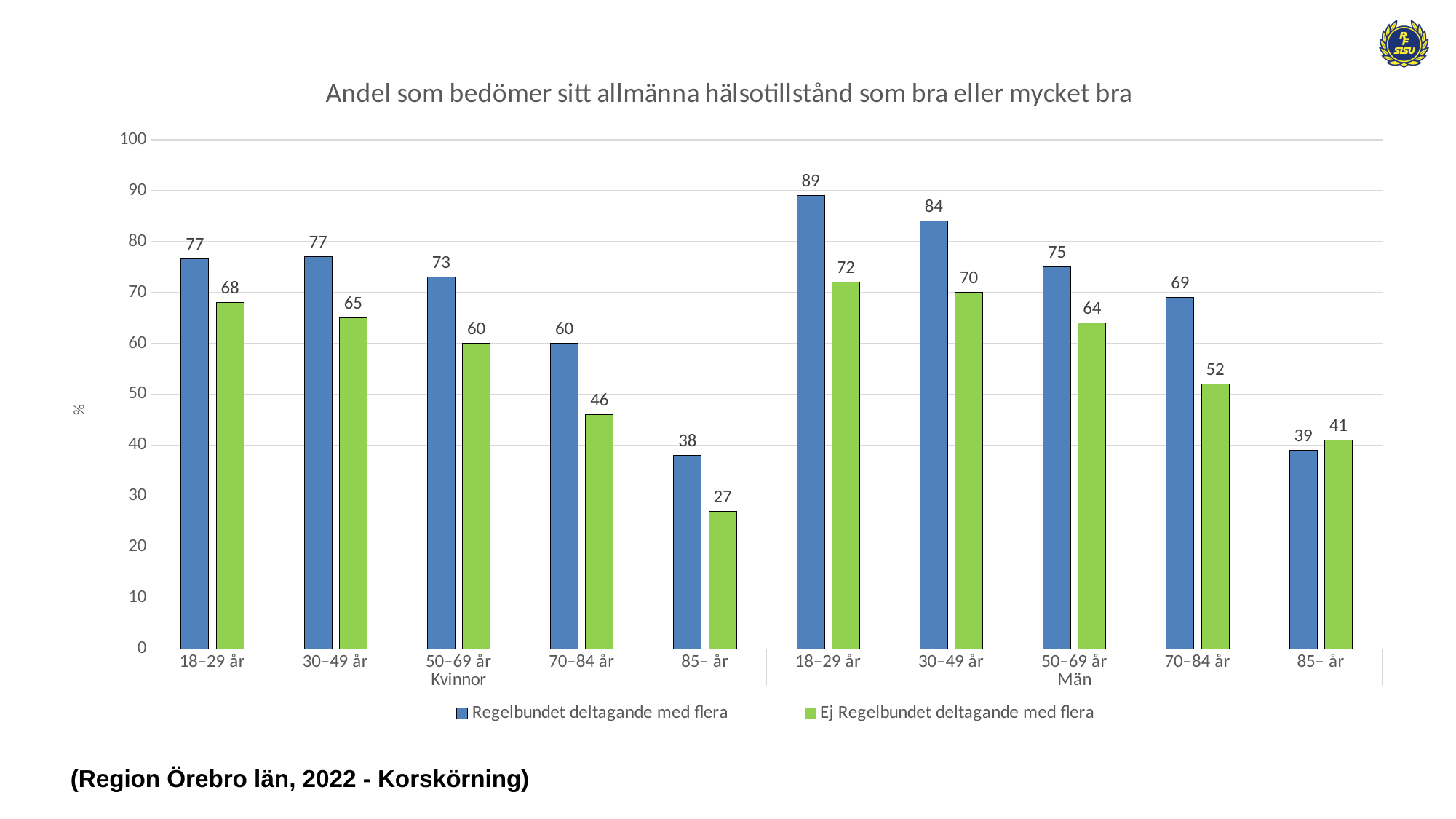
How many age-group categories are shown on the x axis in total? 10 What colour are the bars for 'Ej Regelbundet deltagande med flera'? Green How many series does the legend list? 2 What is the title of the chart? Andel som bedömer sitt allmänna hälsotillstånd som bra eller mycket bra What is the value for 'Ej Regelbundet deltagande med flera' for Män aged 70–84 år? 52 What is the difference between 'Regelbundet deltagande med flera' and 'Ej Regelbundet deltagande med flera' for Kvinnor aged 70–84 år? 14 Which group has the highest value for 'Regelbundet deltagande med flera'? Män 18–29 år Do the values for 'Regelbundet deltagande med flera' among Kvinnor rise or fall from 18–29 år to 85– år? Fall What is the value for 'Regelbundet deltagande med flera' for Kvinnor aged 18–29 år? 77 What kind of chart is shown on the slide? Bar chart For Män aged 85– år, which is larger: 'Regelbundet deltagande med flera' or 'Ej Regelbundet deltagande med flera'? Ej Regelbundet deltagande med flera Which group has the lowest value for 'Ej Regelbundet deltagande med flera'? Kvinnor 85– år